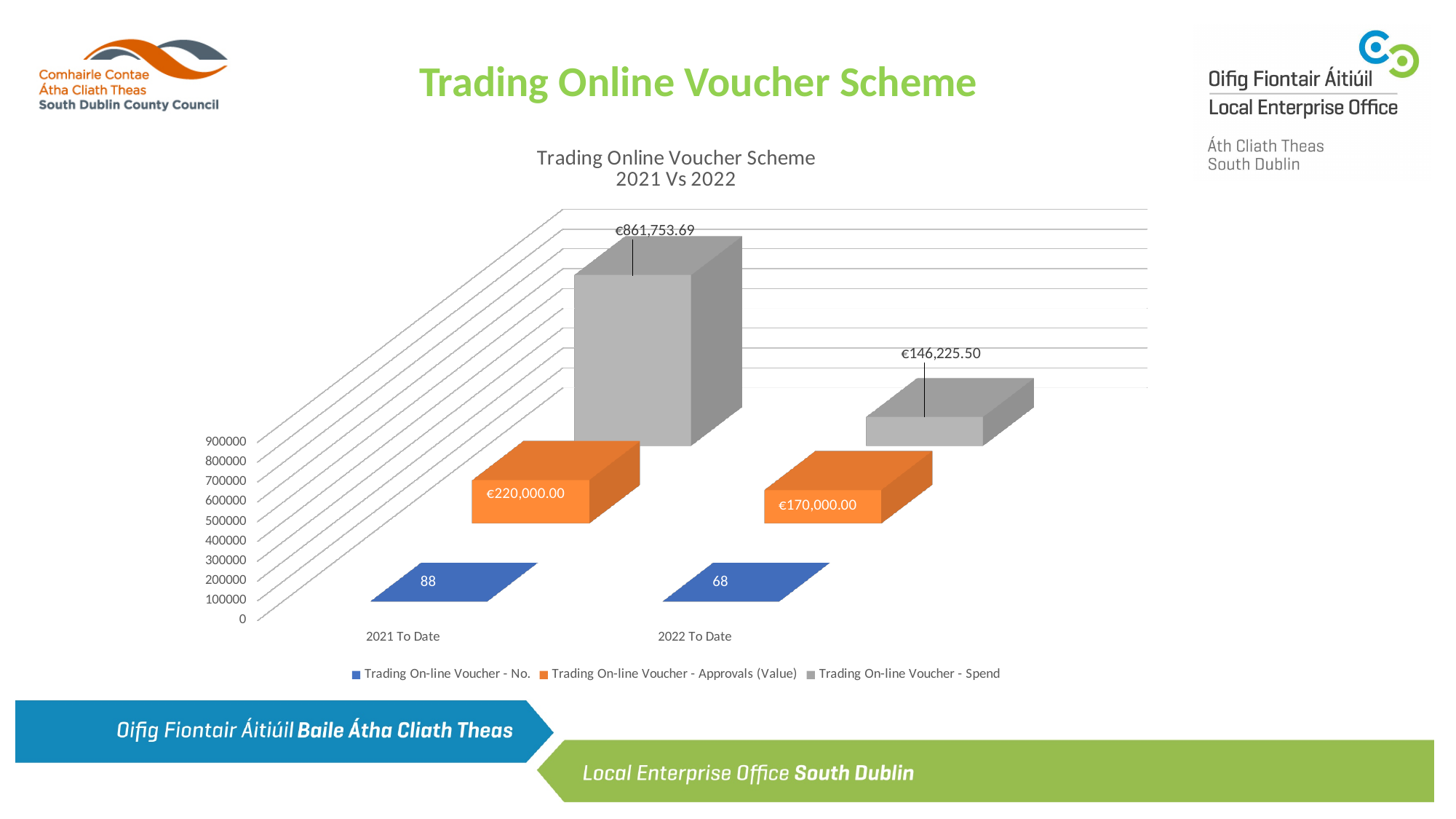
What is the difference in Trading On-line Voucher - No. between 2021 To Date and 2022 To Date? 20 What is the title of the chart? Trading Online Voucher Scheme 2021 Vs 2022 How many series does the legend list? 3 What is the Trading On-line Voucher - No. for 2021 To Date? 88 How many categories are shown on the x axis? 2 What is the Trading On-line Voucher - Spend value for 2021 To Date? €861,753.69 What is the difference in Trading On-line Voucher - Approvals (Value) between 2021 To Date and 2022 To Date? €50,000.00 What is the Trading On-line Voucher - Approvals (Value) for 2022 To Date? €170,000.00 Which category has the higher Trading On-line Voucher - Spend, 2021 To Date or 2022 To Date? 2021 To Date What is the Trading On-line Voucher - No. for 2022 To Date? 68 What is the Trading On-line Voucher - Approvals (Value) for 2021 To Date? €220,000.00 What is the Trading On-line Voucher - Spend value for 2022 To Date? €146,225.50